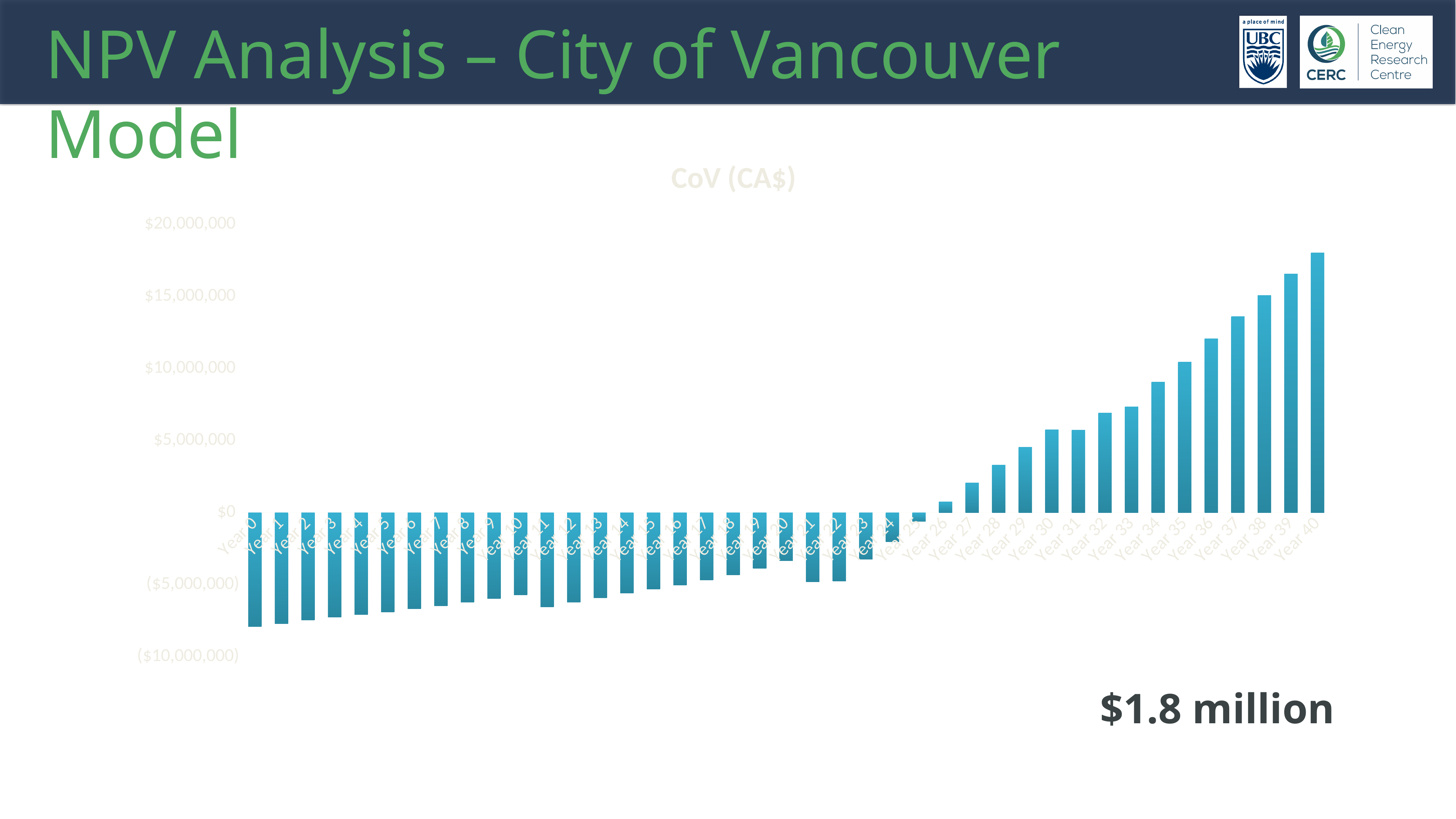
Do the values rise or fall from Year 25 to Year 40? rise Is the value for Year 30 greater or less than $5,000,000? greater Is the value for Year 36 greater or less than $10,000,000? greater What kind of chart is shown on the slide? bar chart Which is larger, the value for Year 40 or the value for Year 30? Year 40 How many years (categories) are plotted on the x axis? 41 Which year has the lowest value? Year 0 Which year has the highest value? Year 40 Is the value for Year 0 greater or less than ($5,000,000)? less What is the title of the chart? CoV (CA$) What figure is printed in large text at the bottom right of the slide? $1.8 million